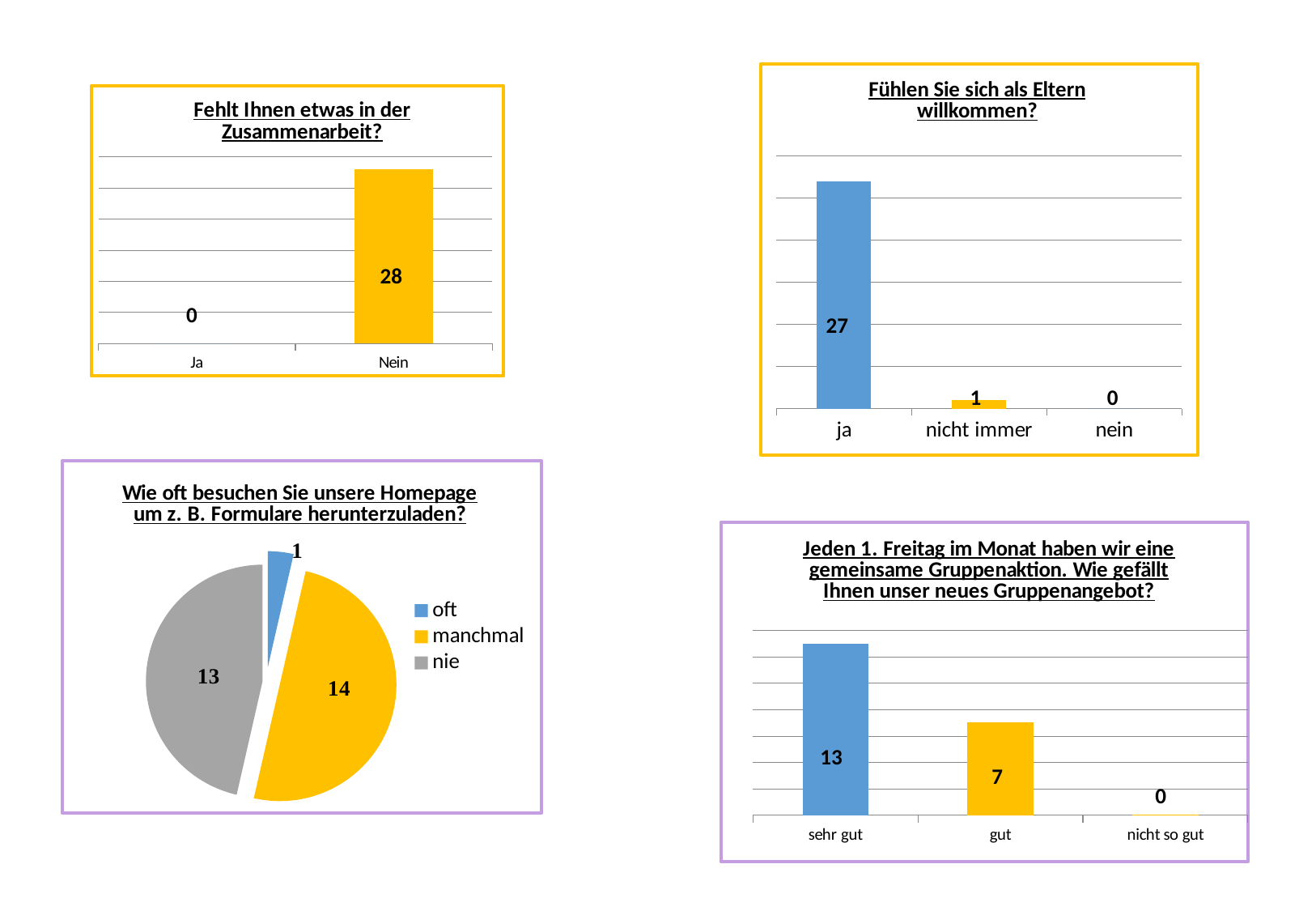
In the chart titled "Fehlt Ihnen etwas in der Zusammenarbeit?", what is the value for Ja? 0 In the pie chart titled "Wie oft besuchen Sie unsere Homepage um z. B. Formulare herunterzuladen?", how many entries does the legend list? 3 In the chart titled "Fühlen Sie sich als Eltern willkommen?", what is the difference between ja and nicht immer? 26 In the chart titled "Fühlen Sie sich als Eltern willkommen?", how many categories are shown on the x axis? 3 In the pie chart titled "Wie oft besuchen Sie unsere Homepage um z. B. Formulare herunterzuladen?", which category has the smallest slice? oft What kind of chart is the one titled "Wie oft besuchen Sie unsere Homepage um z. B. Formulare herunterzuladen?"? pie chart In the pie chart titled "Wie oft besuchen Sie unsere Homepage um z. B. Formulare herunterzuladen?", what is the value for manchmal? 14 In the chart titled "Jeden 1. Freitag im Monat haben wir eine gemeinsame Gruppenaktion. Wie gefällt Ihnen unser neues Gruppenangebot?", which is larger, sehr gut or gut? sehr gut In the chart titled "Fühlen Sie sich als Eltern willkommen?", which category has the highest value? ja In the chart titled "Jeden 1. Freitag im Monat haben wir eine gemeinsame Gruppenaktion. Wie gefällt Ihnen unser neues Gruppenangebot?", what is the value for gut? 7 In the chart titled "Fühlen Sie sich als Eltern willkommen?", what is the value for ja? 27 In the chart titled "Fehlt Ihnen etwas in der Zusammenarbeit?", what is the value for Nein? 28